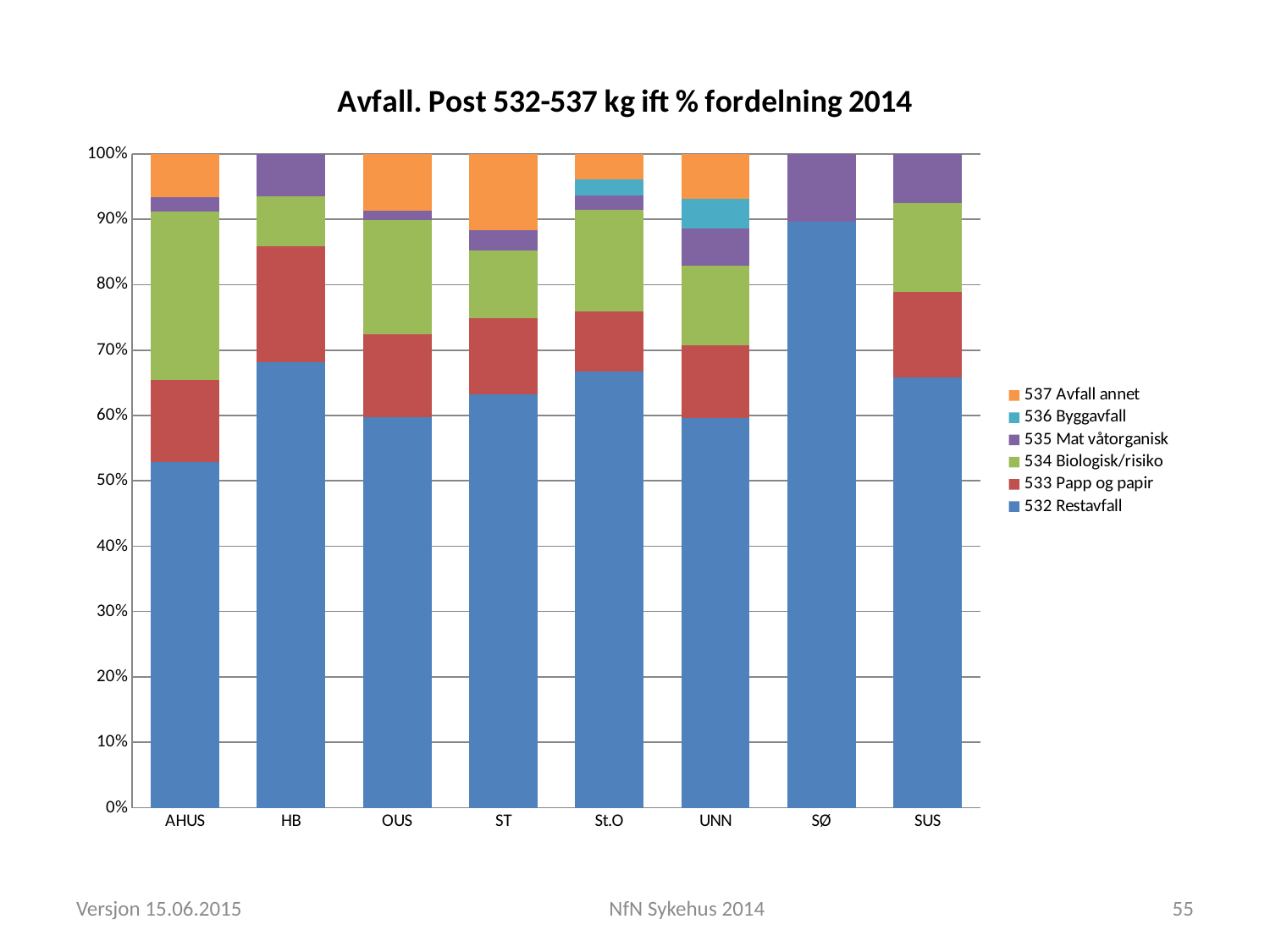
Which has a larger share of 532 Restavfall, SØ or AHUS? SØ Is the share of 532 Restavfall for AHUS greater or less than 60%? less Is the share of 532 Restavfall for SØ greater or less than 80%? greater What is the title of the chart? Avfall. Post 532-537 kg ift % fordelning 2014 How many hospitals (categories) are shown on the x axis? 8 Is the share of 532 Restavfall for HB greater or less than 60%? greater What kind of chart is shown on the slide? Stacked bar chart Which hospital has the lowest share of 532 Restavfall? AHUS How many series does the legend list? 6 What is the total of the stacked bar for AHUS? 100% Which hospital has the highest share of 532 Restavfall? SØ Which colour represents 532 Restavfall in the legend? Blue